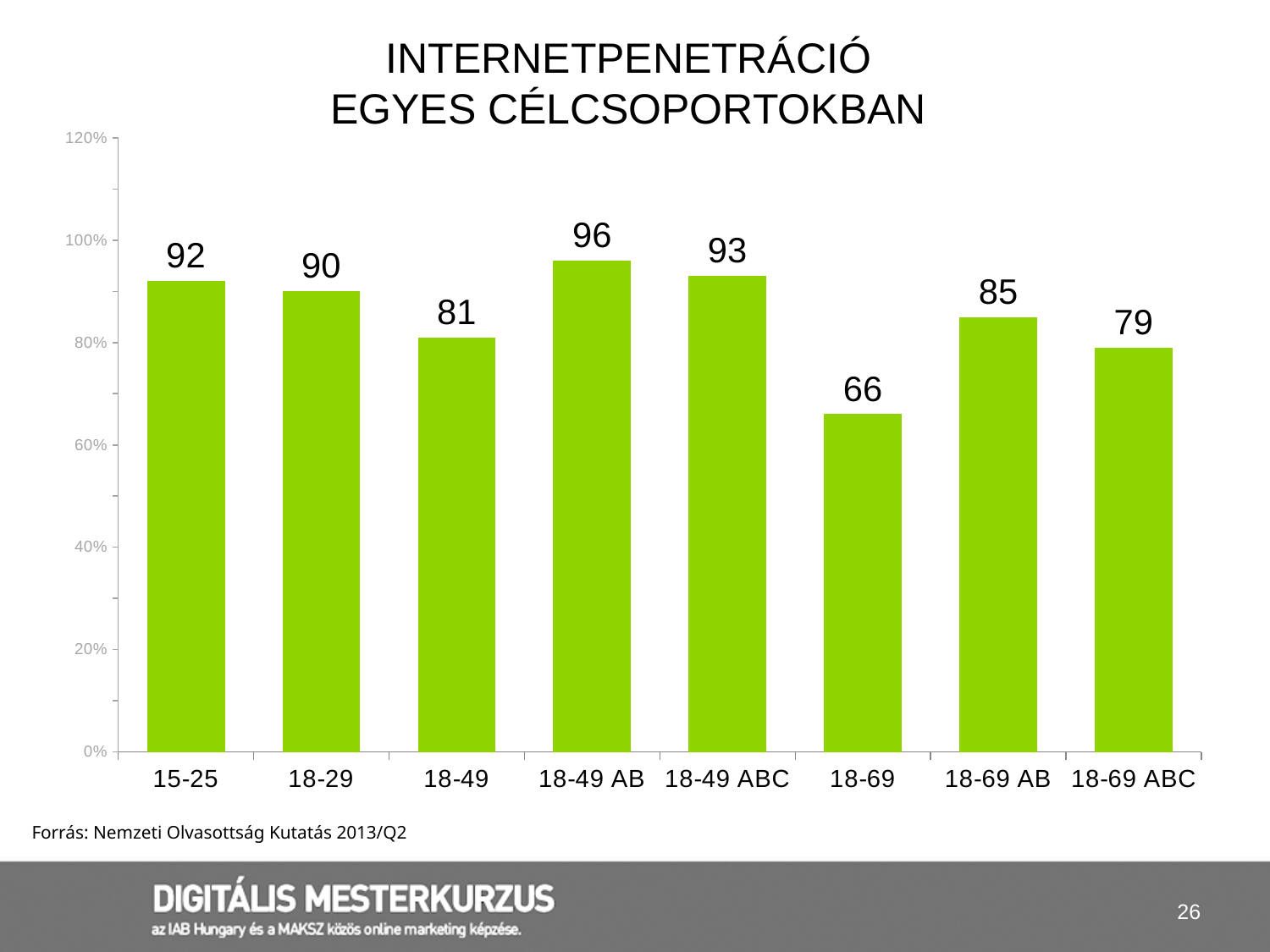
What kind of chart is shown on the slide? bar chart Which group has the highest value? 18-49 AB What is the difference between the values for 18-49 AB and 18-49? 15 How many groups are shown on the x axis? 8 Is the value for 18-49 ABC greater or less than 80%? greater Which is larger, the value for 18-29 or the value for 18-69 AB? 18-29 What is the value for the 18-69 group? 66 What is the value for the 15-25 group? 92 What is the title of the chart? INTERNETPENETRÁCIÓ EGYES CÉLCSOPORTOKBAN Which group has the lowest value? 18-69 What is the value for the 18-69 ABC group? 79 What is the difference between the values for 18-69 AB and 18-69? 19